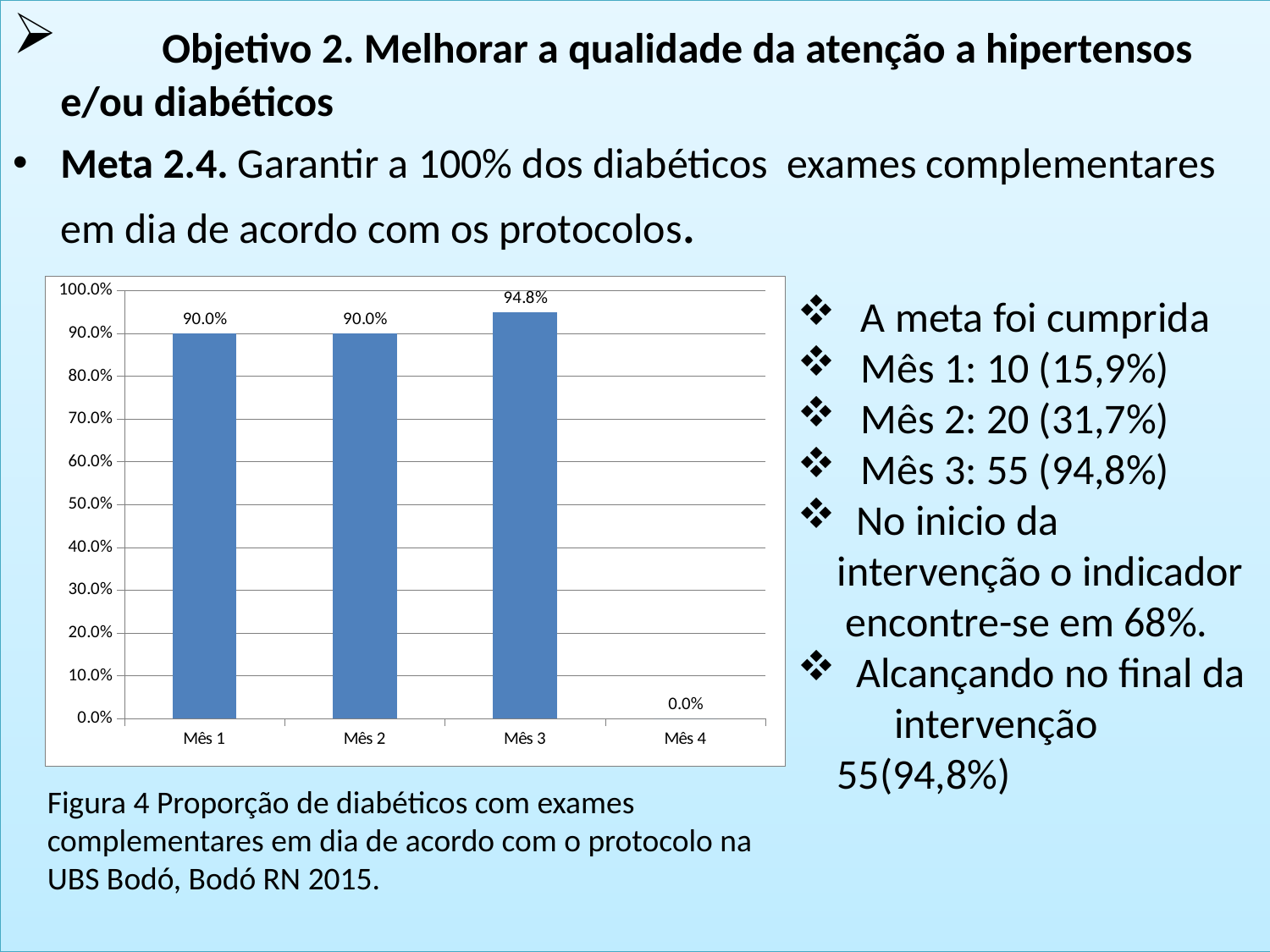
What is the difference between the values for Mês 3 and Mês 2? 4.8% What is the value for Mês 4? 0.0% What kind of chart is shown on the slide? bar chart How many categories are shown on the x axis? 4 Which category has the lowest value? Mês 4 What is the value for Mês 3? 94.8% What is the value for Mês 1? 90.0% Which is larger, the value for Mês 3 or the value for Mês 1? Mês 3 Which category has the highest value? Mês 3 What is the difference between the values for Mês 3 and Mês 4? 94.8% Is the value for Mês 2 greater or less than 80.0%? greater Do the values for Mês 1 and Mês 2 have the same value? Yes, both are 90.0%